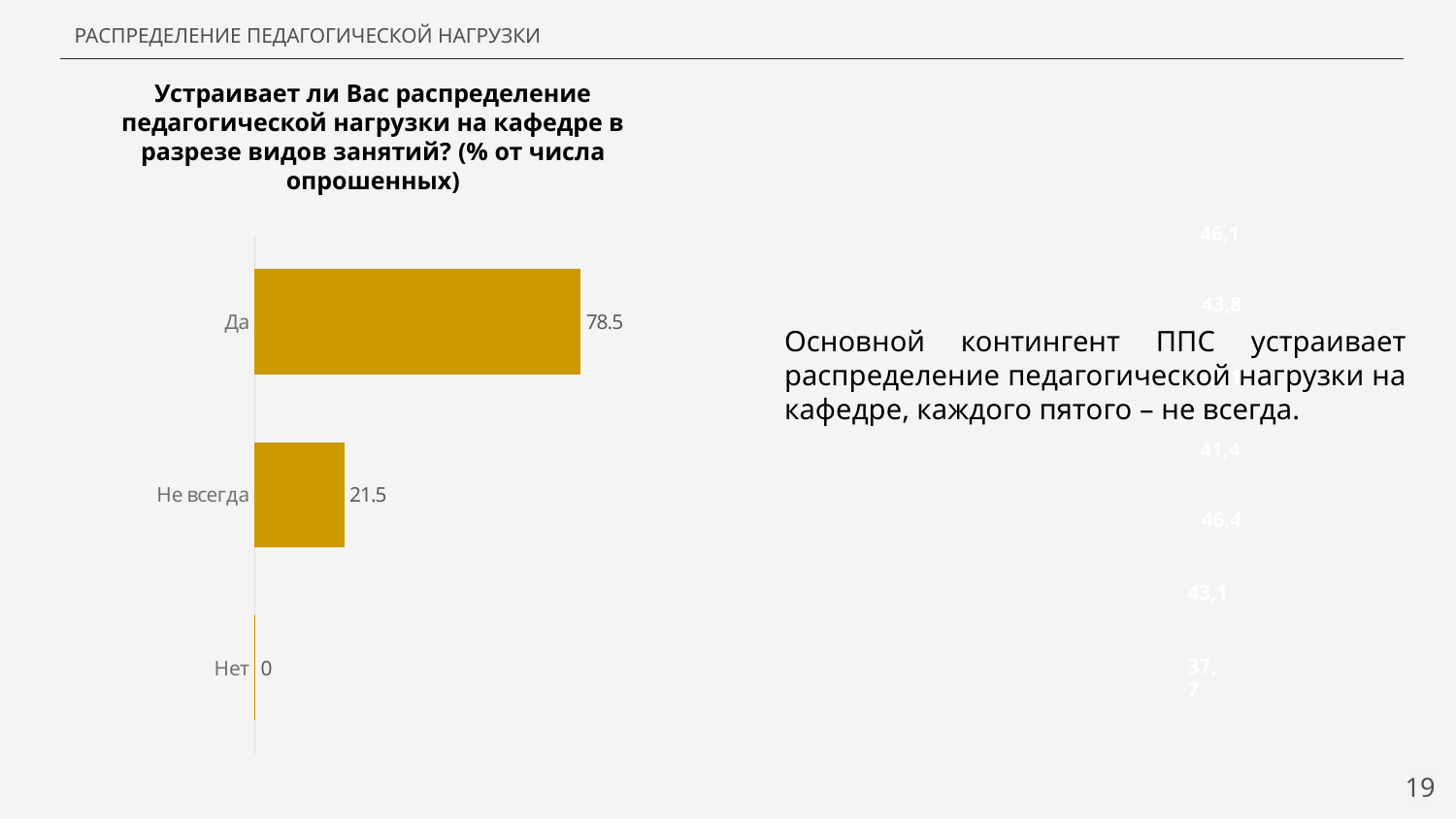
What is the difference between the values for "Да" and "Не всегда"? 57 Which category has the highest value? Да How many categories are shown in the chart? 3 What value is shown for "Нет"? 0 Which category has the lowest value? Нет Which category is listed at the top of the chart? Да What colour are the bars in the chart? Gold (dark yellow) What value is shown for "Не всегда"? 21.5 What is the total of the values for "Да", "Не всегда" and "Нет"? 100 What kind of chart is shown on the slide? Bar chart What value is shown for "Да"? 78.5 Which is larger, the value for "Да" or the value for "Не всегда"? Да